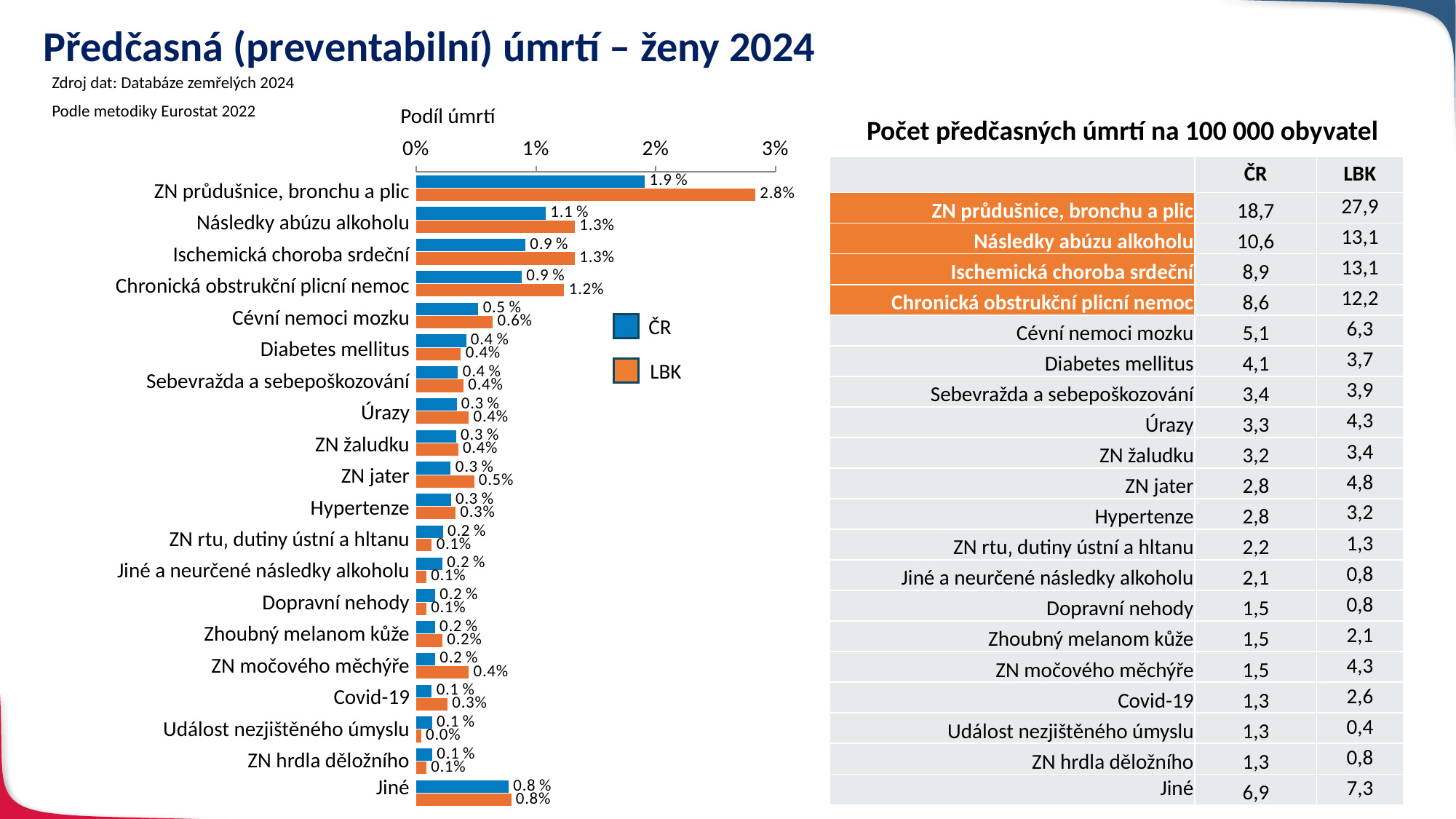
In the bar chart, what is the ČR value for Jiné? 0.8 % In the bar chart, what is the LBK value for ZN jater? 0.5% Which category has the lowest LBK value in the bar chart? Událost nezjištěného úmyslu In the bar chart, is the LBK value for ZN průdušnice, bronchu a plic greater or less than 2%? greater In the bar chart, what is the LBK value for ZN průdušnice, bronchu a plic? 2.8% Which category has the highest LBK value in the bar chart? ZN průdušnice, bronchu a plic How many categories (causes of death) are plotted in the bar chart? 20 In the bar chart, is the ČR or the LBK value larger for ZN močového měchýře? LBK What type of chart is shown on the left of the slide? bar chart In the bar chart, what is the difference between the LBK and ČR values for ZN průdušnice, bronchu a plic? 0.9 percentage points In the bar chart, what is the ČR value for Následky abúzu alkoholu? 1.1 % How many series does the legend of the bar chart list? 2